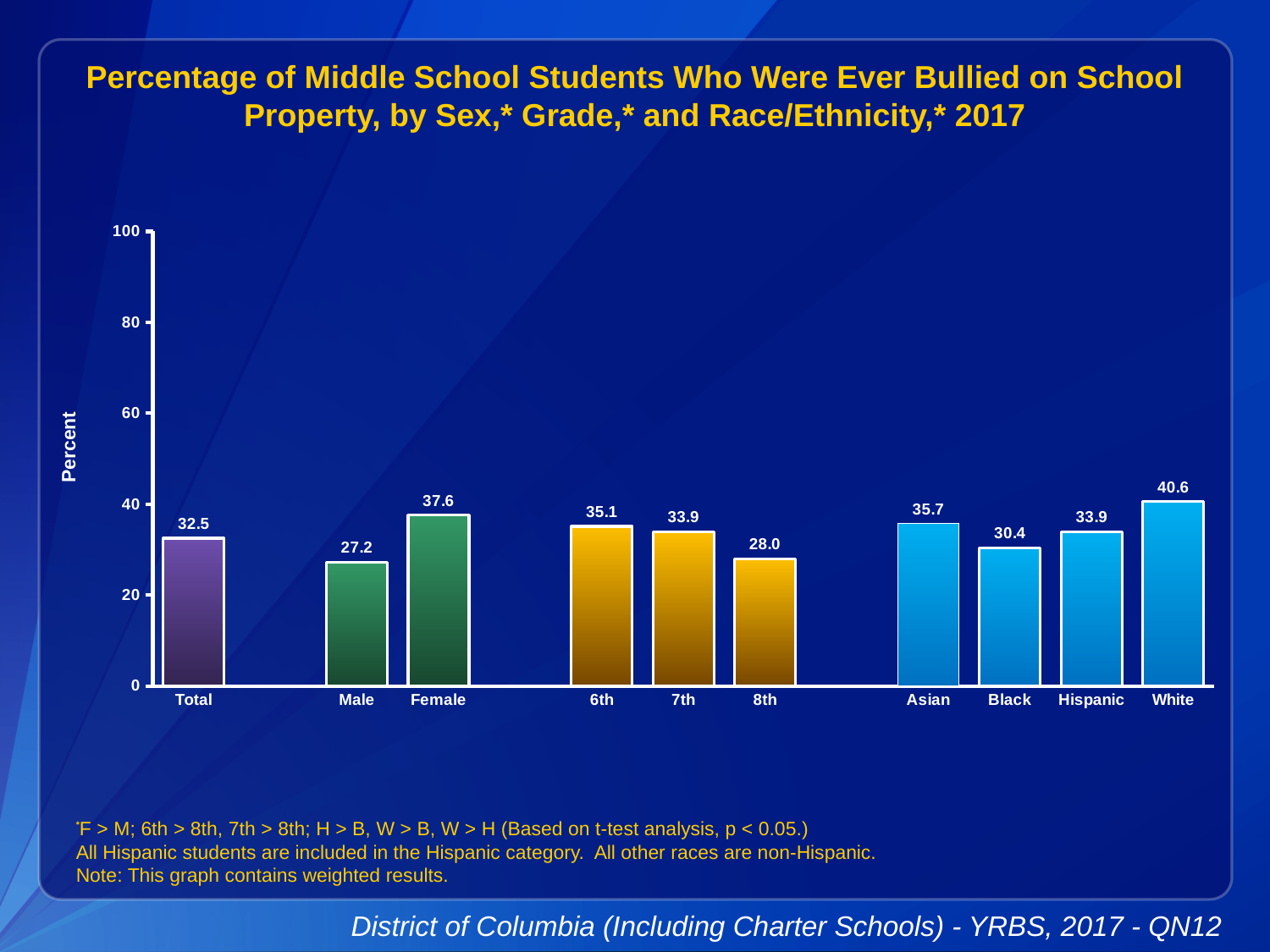
What is the label on the y axis? Percent What is the value for Female? 37.6 Is the value for White greater or less than 40? greater What is the difference between the Female and Male values? 10.4 What is the value for 8th grade? 28.0 What kind of chart is this? Bar chart What is the value for Total? 32.5 Which category has the lowest value? Male Which category has the highest value? White Do the values fall or rise from 6th to 8th grade? Fall How many categories are shown on the x axis? 11 Which is larger, the value for Asian or the value for Black? Asian